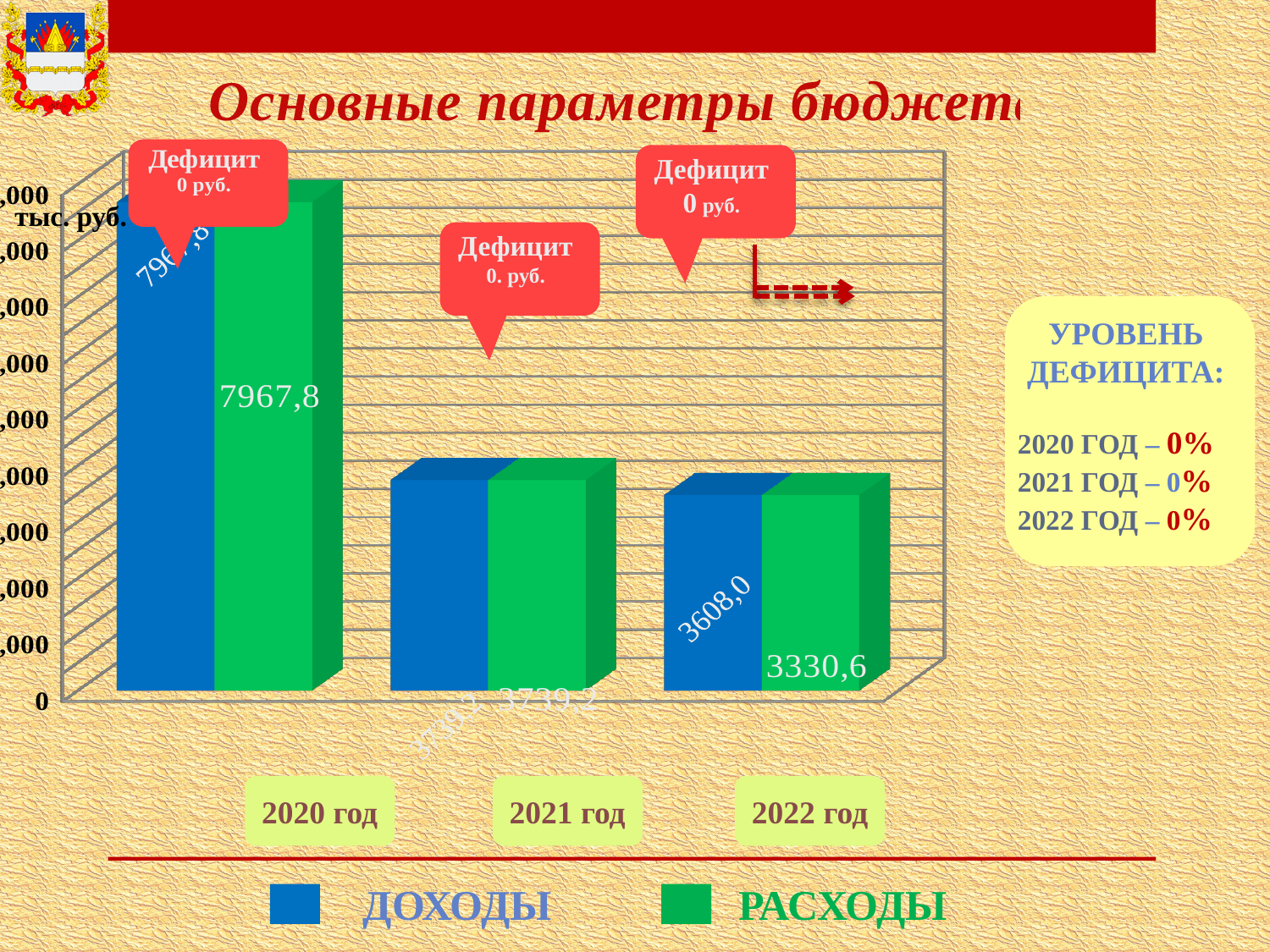
What is the value of РАСХОДЫ for 2021 год? 3739,2 Which year has the lowest РАСХОДЫ value? 2022 год How many series does the legend list? 2 What kind of chart is shown on the slide? Bar chart What is the value of РАСХОДЫ for 2020 год? 7967,8 What is the value of РАСХОДЫ for 2022 год? 3330,6 Which is larger for 2022 год, ДОХОДЫ or РАСХОДЫ? ДОХОДЫ Which year has the highest РАСХОДЫ value? 2020 год Do the РАСХОДЫ values rise or fall from 2020 год to 2022 год? Fall What is the difference between ДОХОДЫ and РАСХОДЫ for 2022 год? 277,4 What is the value of ДОХОДЫ for 2022 год? 3608,0 How many years are shown on the chart? 3